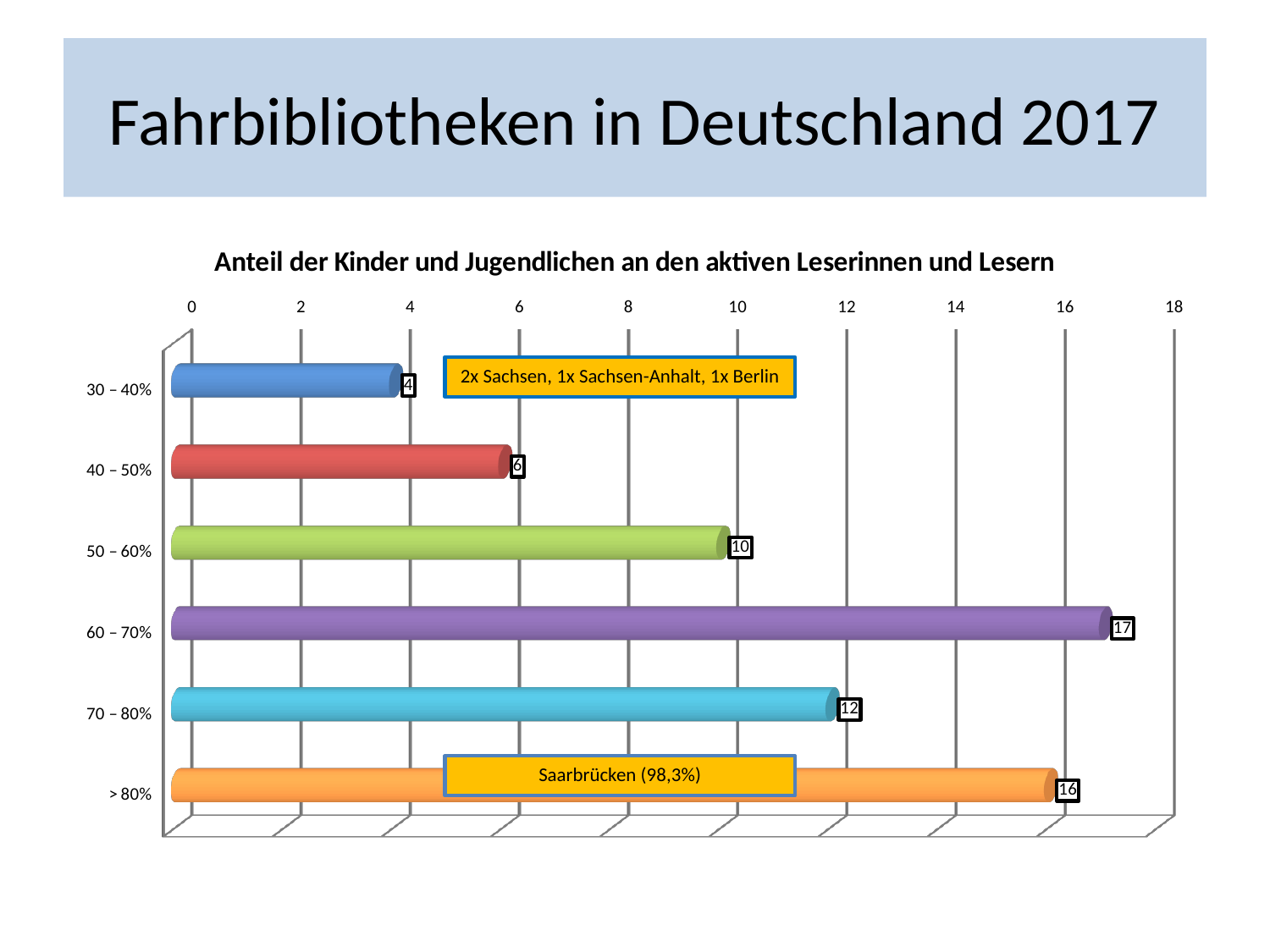
Which category has the lowest value? 30 – 40% Which is larger, the value for 70 – 80% or the value for 50 – 60%? 70 – 80% What is the title of the chart? Anteil der Kinder und Jugendlichen an den aktiven Leserinnen und Lesern What is the difference between the values for 60 – 70% and 70 – 80%? 5 What is the value for the 30 – 40% category? 4 How many categories are shown in the chart? 6 What kind of chart is shown on the slide? bar chart What is the value for the 60 – 70% category? 17 What is the value for the > 80% category? 16 What is the difference between the values for 50 – 60% and 40 – 50%? 4 What does the annotation box on the > 80% bar say? Saarbrücken (98,3%) Which category has the highest value? 60 – 70%